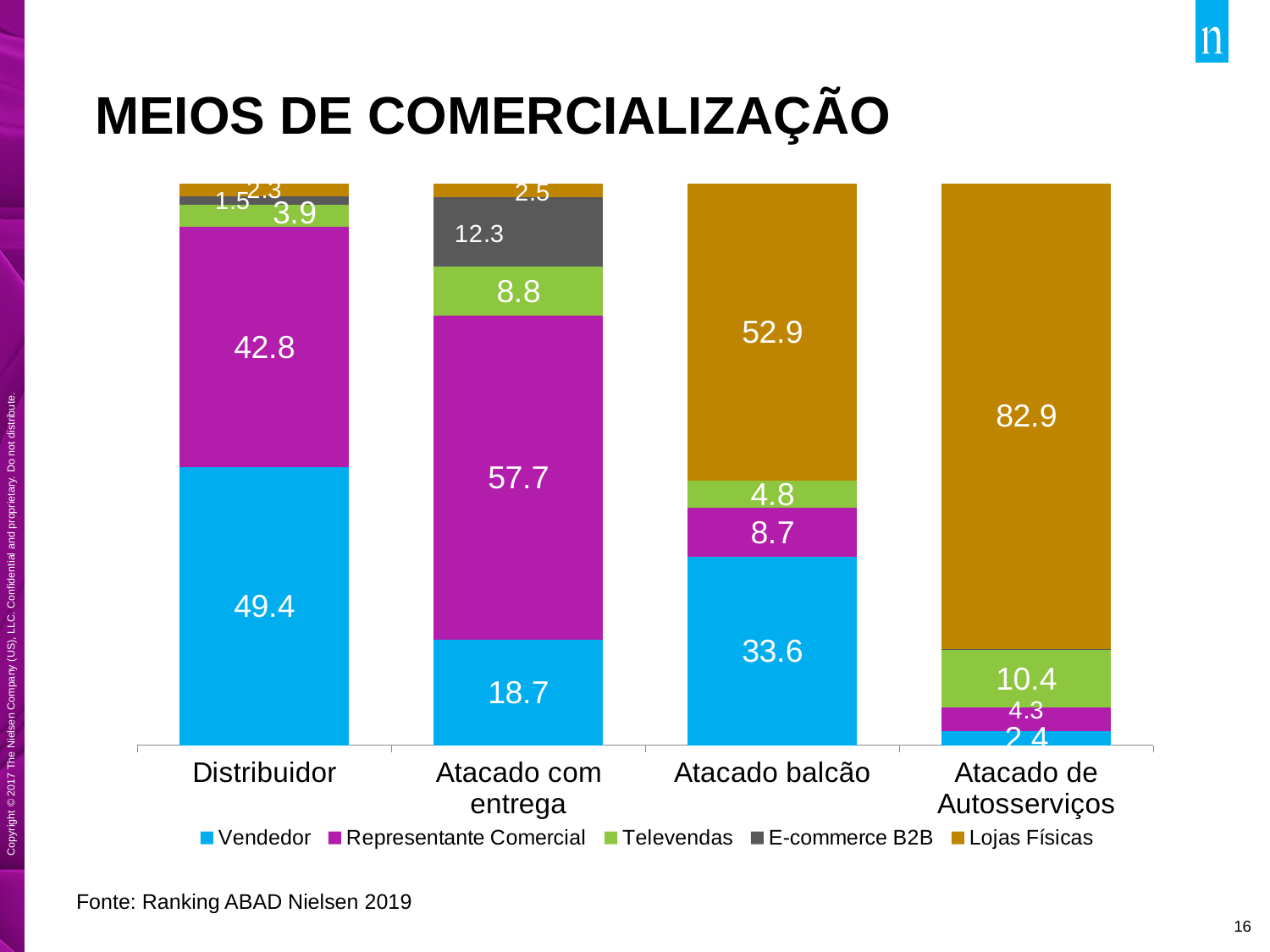
Which is larger: the Televendas value for Atacado de Autosserviços or for Atacado com entrega? Atacado de Autosserviços What is the difference between the Lojas Físicas values for Atacado de Autosserviços and Atacado balcão? 30.0 Which category has the highest Lojas Físicas value? Atacado de Autosserviços Which category has the lowest Vendedor value? Atacado de Autosserviços What is the Vendedor value for Distribuidor? 49.4 What is the Representante Comercial value for Atacado com entrega? 57.7 How many categories are shown on the x axis? 4 What type of chart is shown on the slide? Stacked bar chart What is the title of the chart? MEIOS DE COMERCIALIZAÇÃO What is the Lojas Físicas value for Atacado de Autosserviços? 82.9 How many series does the legend list? 5 What is the E-commerce B2B value for Atacado com entrega? 12.3